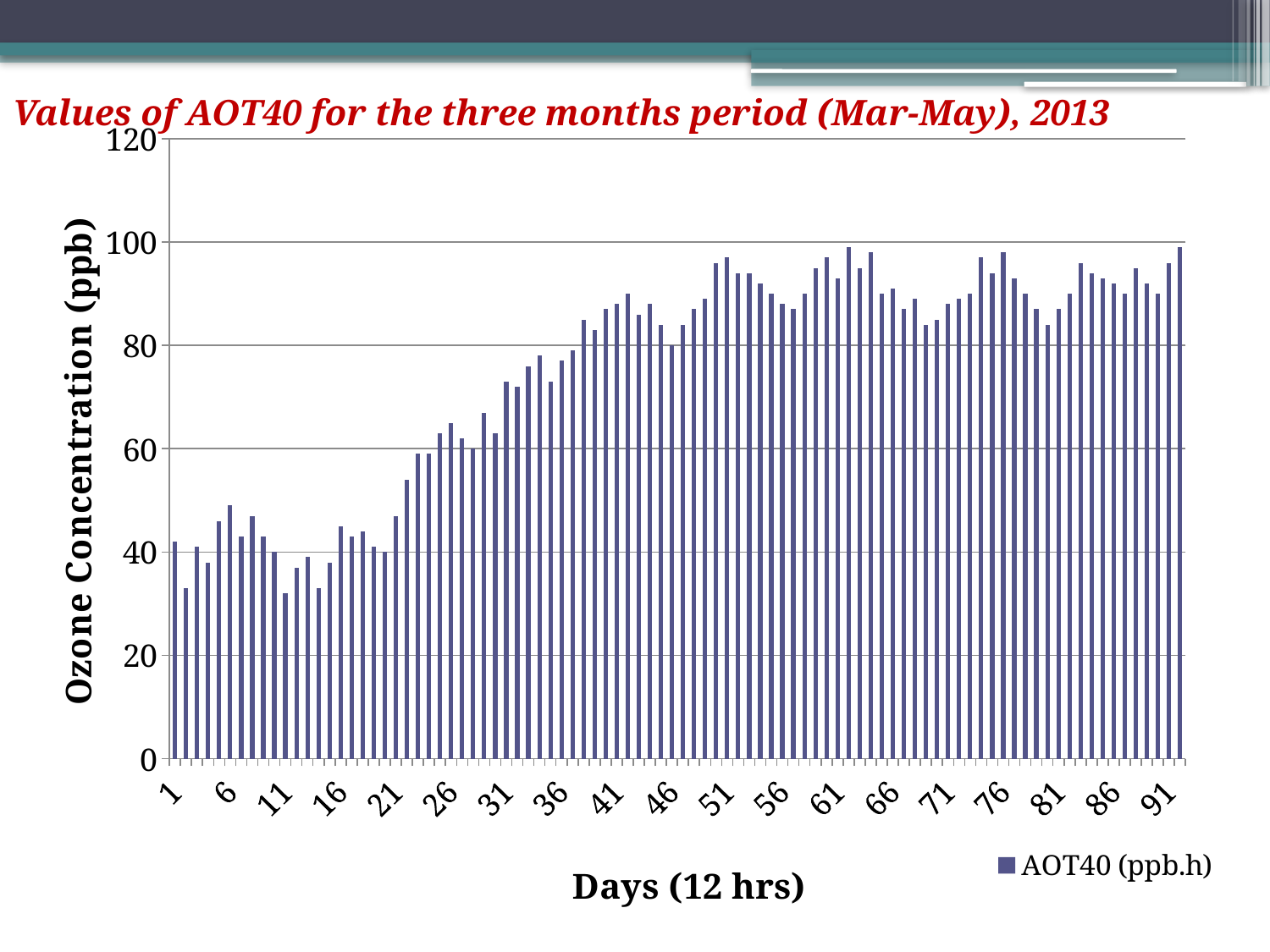
Is the value for day 11 greater or less than 40? less Is the value for day 31 greater or less than 60? greater Do the values generally rise or fall from day 1 to day 91? rise What kind of chart is shown on the slide? bar chart Is the value for day 61 greater or less than 80? greater How many series does the legend list? 1 Which is larger, the value for day 11 or the value for day 41? day 41 Which is larger, the value for day 6 or the value for day 31? day 31 What is the name of the series shown in the legend? AOT40 (ppb.h) What is the title of the chart? Values of AOT40 for the three months period (Mar-May), 2013